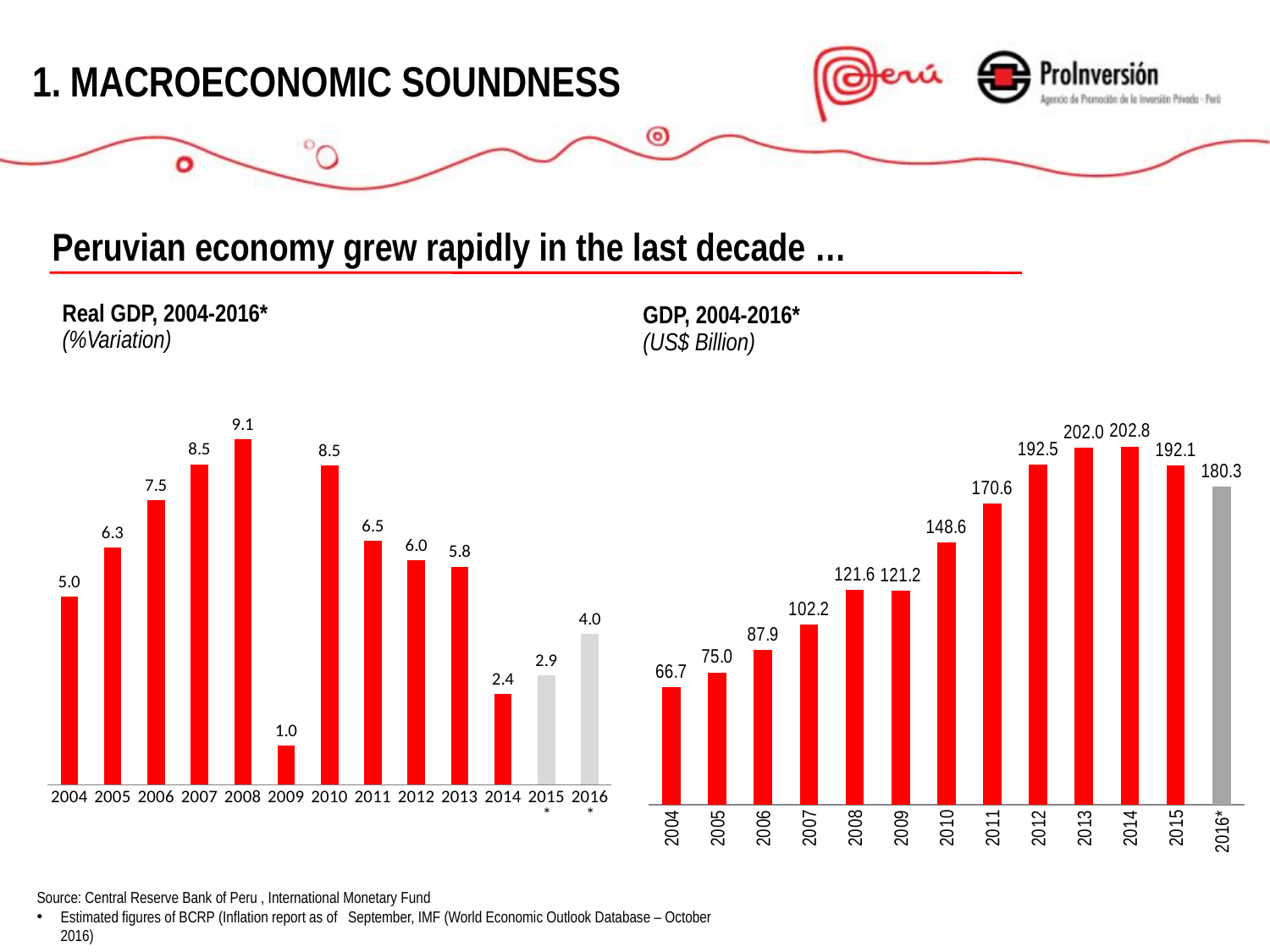
In the GDP (US$ Billion) chart, do the values generally rise or fall from 2004 to 2014? Rise What kind of chart is the GDP (US$ Billion) chart? Bar chart In the GDP (US$ Billion) chart, which year has the lowest value? 2004 In the GDP (US$ Billion) chart, what is the value for 2011? 170.6 In the Real GDP (%Variation) chart, which is larger, the value for 2005 or the value for 2013? 2005 In the GDP (US$ Billion) chart, which is larger, the value for 2008 or the value for 2009? 2008 In the GDP (US$ Billion) chart, what is the difference between the values for 2015 and 2016*? 11.8 In the Real GDP (%Variation) chart, how many years are shown on the x axis? 13 In the GDP (US$ Billion) chart, which year has the highest value? 2014 In the Real GDP (%Variation) chart, which year has the lowest value? 2009 In the Real GDP (%Variation) chart, what is the difference between the values for 2010 and 2011? 2.0 In the Real GDP (%Variation) chart, what is the value for 2008? 9.1